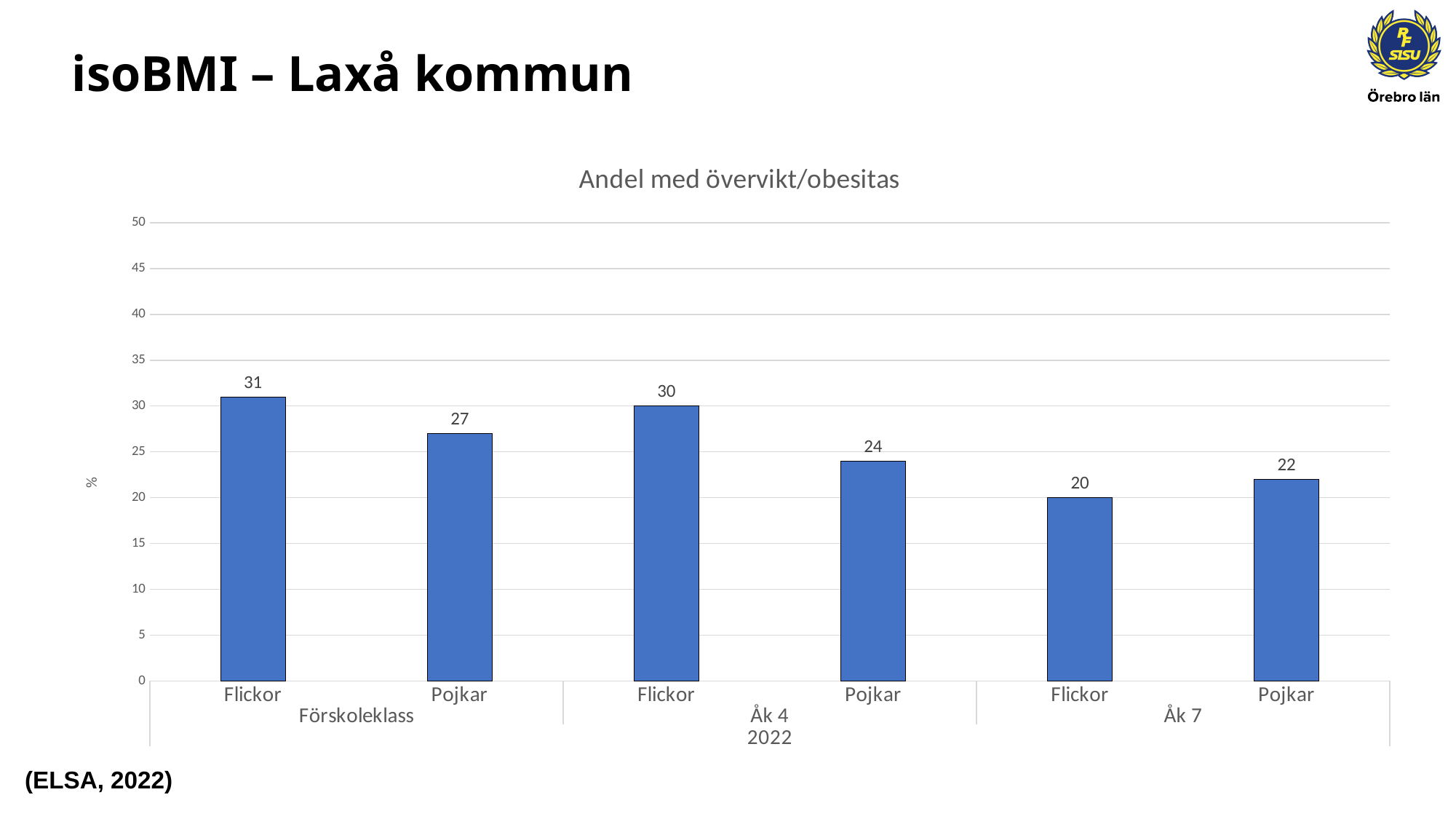
What kind of chart is shown on the slide? Bar chart Which bar has the lowest value? Flickor, Åk 7 What is the value for Flickor in Förskoleklass? 31 What is the difference between Flickor and Pojkar in Åk 4? 6 What is the difference between Flickor and Pojkar in Förskoleklass? 4 How many bars are plotted in the chart? 6 Is the value for Pojkar in Förskoleklass greater or less than 25? greater Which is larger in Åk 7, Flickor or Pojkar? Pojkar What is the value for Pojkar in Åk 4? 24 Which bar has the highest value? Flickor, Förskoleklass What is the title of the chart? Andel med övervikt/obesitas What is the value for Flickor in Åk 7? 20